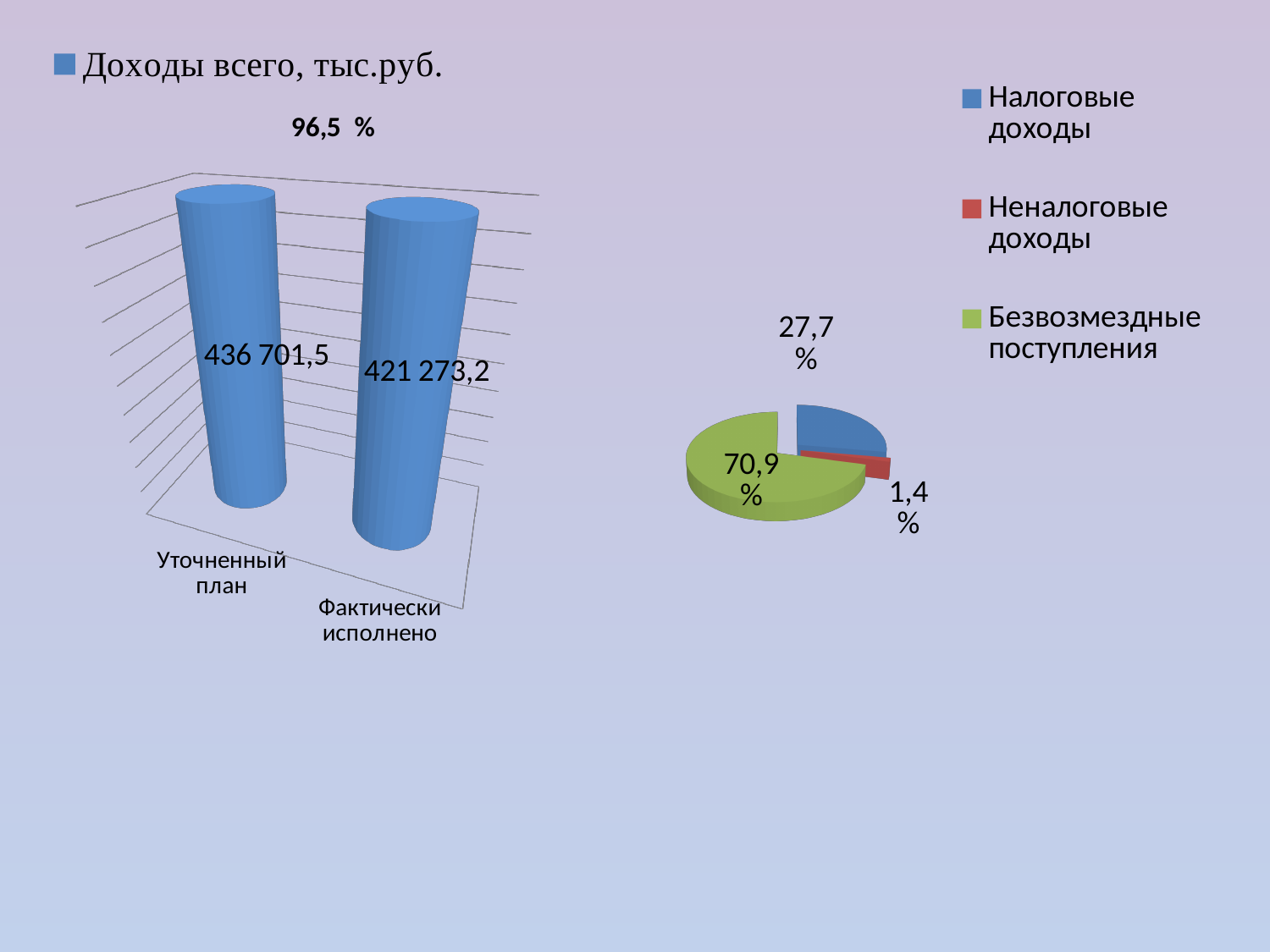
On the pie chart on the right, which category has the smallest share? Неналоговые доходы On the pie chart on the right, how many categories does the legend list? 3 On the left bar chart, what percentage is printed above the bars? 96,5 % On the pie chart on the right, what share is Налоговые доходы? 27,7 % On the left bar chart, what is the value for Уточненный план? 436 701,5 On the left bar chart, how many categories are shown? 2 On the pie chart on the right, what share is Безвозмездные поступления? 70,9 % On the left bar chart, what is the difference between Уточненный план and Фактически исполнено? 15 428,3 On the left bar chart, which category has the higher value? Уточненный план On the pie chart on the right, what colour is the slice for Неналоговые доходы? Red On the left bar chart, what is the value for Фактически исполнено? 421 273,2 What kind of chart is the chart on the left of the slide? Bar chart